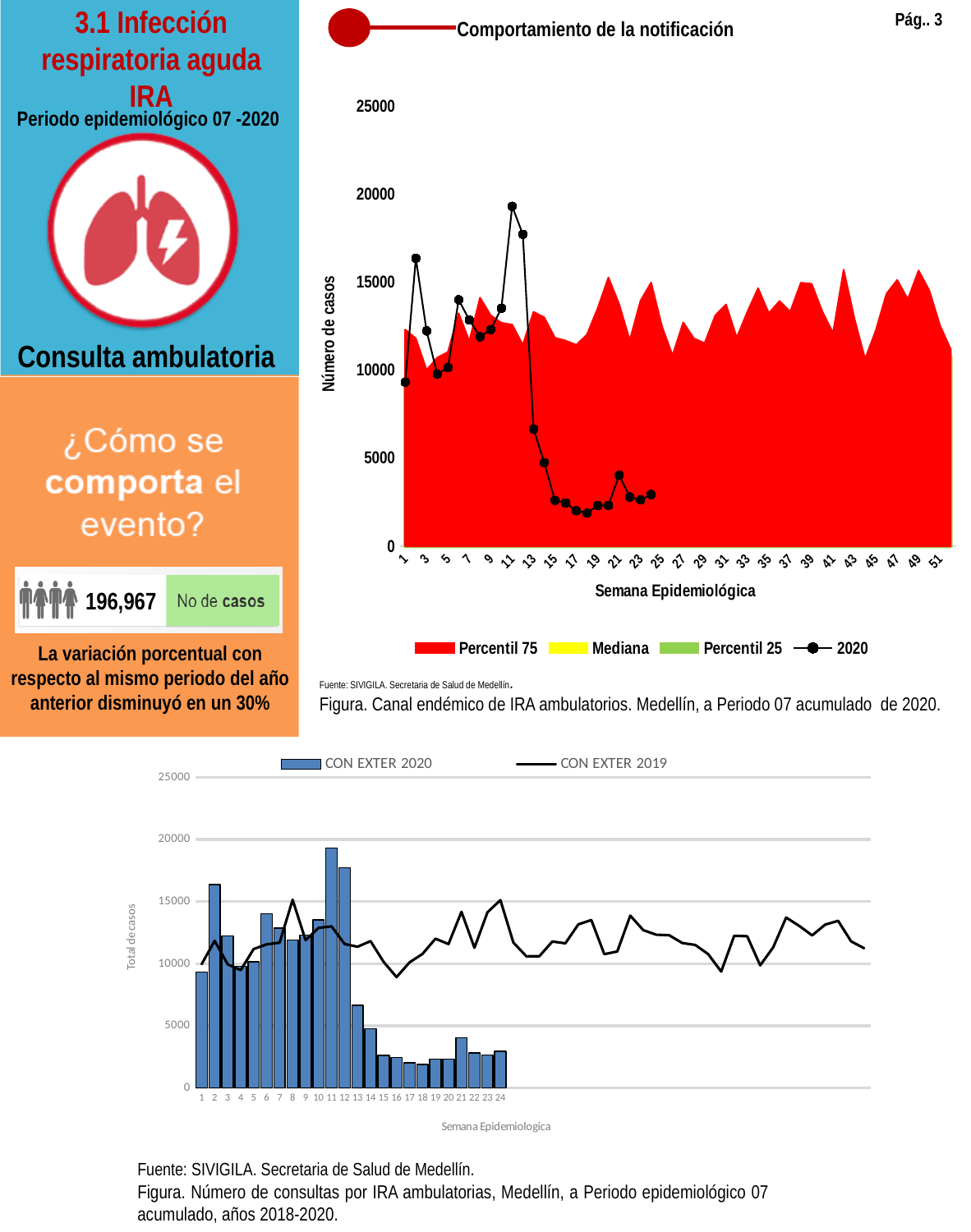
In the top chart 'Comportamiento de la notificación', how many series does the legend list? 4 In the bottom chart, how many series does the legend list? 2 In the bottom chart, how many bars are plotted for CON EXTER 2020? 24 In the top chart 'Comportamiento de la notificación', does the 2020 line rise or fall between week 12 and week 17? fall In the bottom chart, which CON EXTER 2020 bar is taller, week 2 or week 3? week 2 In the top chart 'Comportamiento de la notificación', at which epidemiological week does the 2020 line reach its highest value? 11 In the bottom chart, is the CON EXTER 2020 bar for week 13 greater or less than 5000? greater In the top chart 'Comportamiento de la notificación', what is the title of the y axis? Número de casos In the top chart 'Comportamiento de la notificación', is the 2020 value at week 1 greater or less than 10000? less In the top chart 'Comportamiento de la notificación', is the 2020 value at week 15 greater or less than 5000? less In the bottom chart, which epidemiological week has the highest CON EXTER 2020 bar? 11